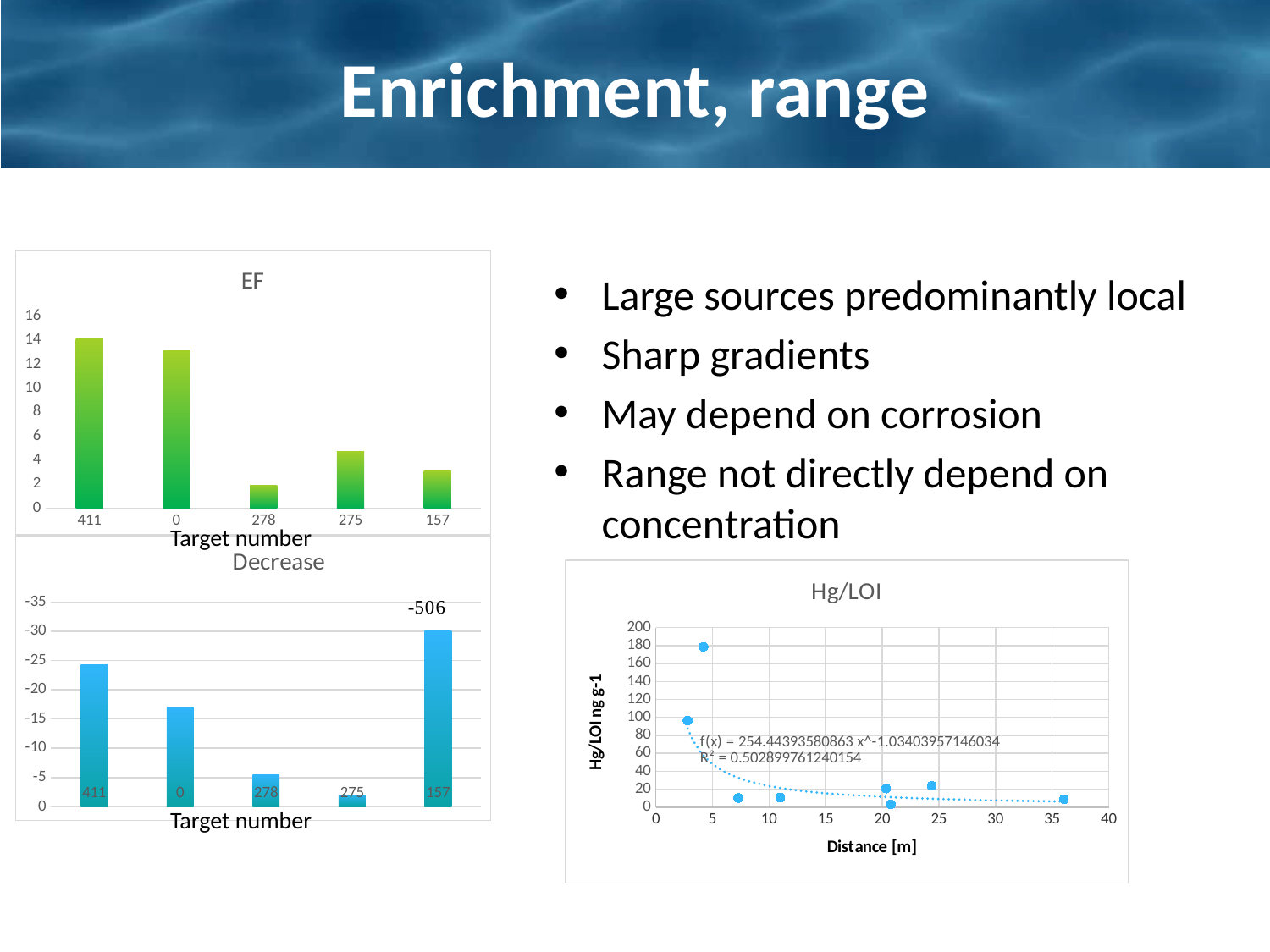
In the EF chart, which target number has the lowest bar? 278 In the Decrease chart, which bar is longer, 411 or 0? 411 What kind of chart is the EF chart? bar chart In the EF chart, which target number has the highest bar? 411 In the EF chart, which has the larger value, 275 or 157? 275 What kind of chart is the Hg/LOI chart? scatter chart What R² value is printed on the Hg/LOI chart? 0.502899761240154 In the EF chart, is the value for 411 greater or less than 12? greater In the Decrease chart, which target number has the longest bar? 157 In the EF chart, is the value for 275 greater or less than 6? less How many categories are shown on the x axis of the EF chart? 5 How many data points are plotted in the Hg/LOI chart? 8